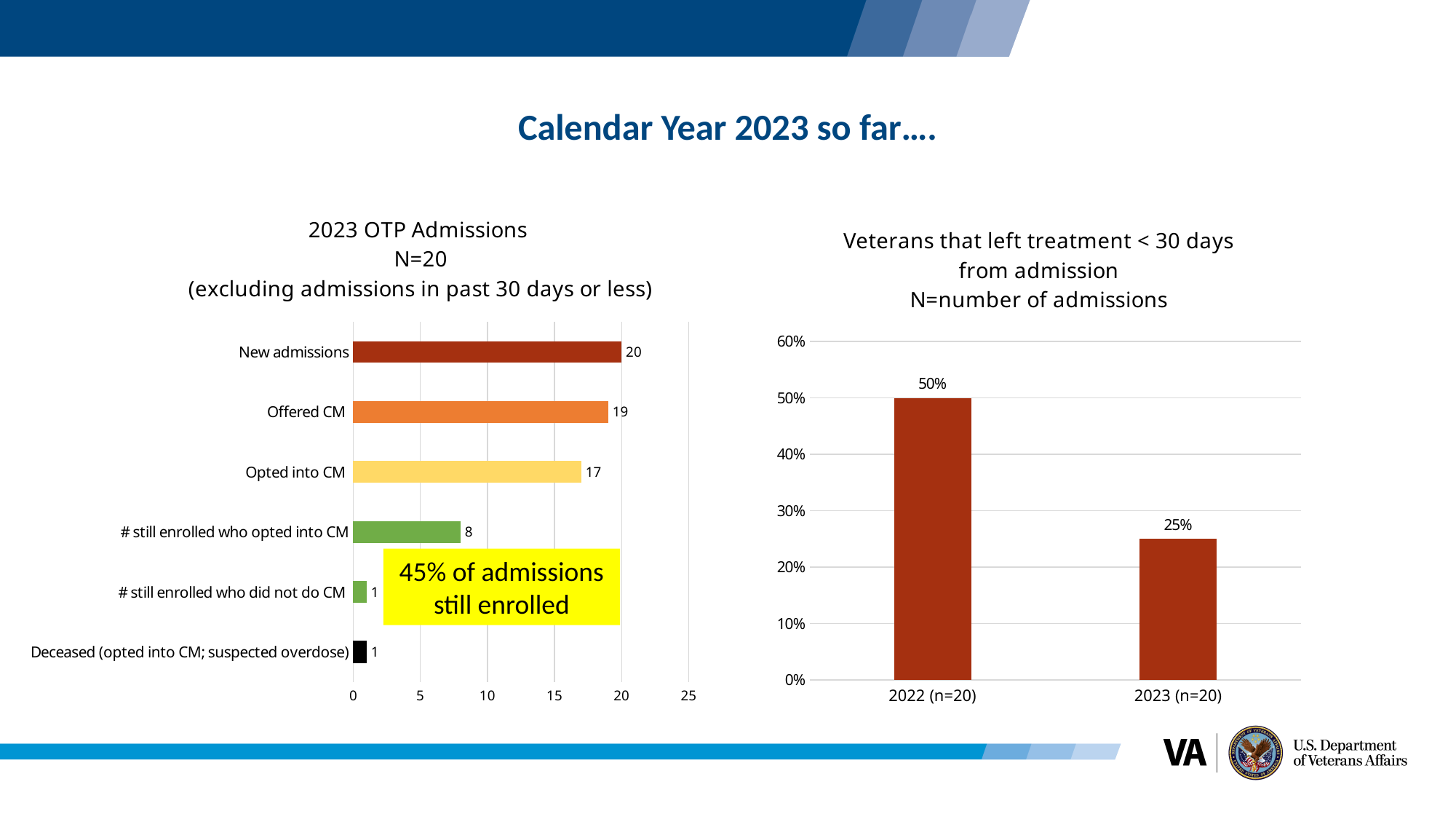
In the '2023 OTP Admissions' chart, which category has the highest value? New admissions In the '2023 OTP Admissions' chart, which is larger: 'Opted into CM' or '# still enrolled who opted into CM'? Opted into CM In the 'Veterans that left treatment < 30 days from admission' chart, what is the value for 2022 (n=20)? 50% In the '2023 OTP Admissions' chart, what is the value for 'Offered CM'? 19 What kind of chart is the '2023 OTP Admissions' chart? Bar chart In the 'Veterans that left treatment < 30 days from admission' chart, do the values rise or fall from 2022 to 2023? Fall In the '2023 OTP Admissions' chart, what is the difference between 'New admissions' and 'Opted into CM'? 3 How many categories are shown in the '2023 OTP Admissions' chart? 6 What does the yellow highlighted text box on the '2023 OTP Admissions' chart say? 45% of admissions still enrolled In the '2023 OTP Admissions' chart, what is the value for '# still enrolled who opted into CM'? 8 In the 'Veterans that left treatment < 30 days from admission' chart, what is the difference between the 2022 and 2023 values? 25% In the 'Veterans that left treatment < 30 days from admission' chart, what is the value for 2023 (n=20)? 25%